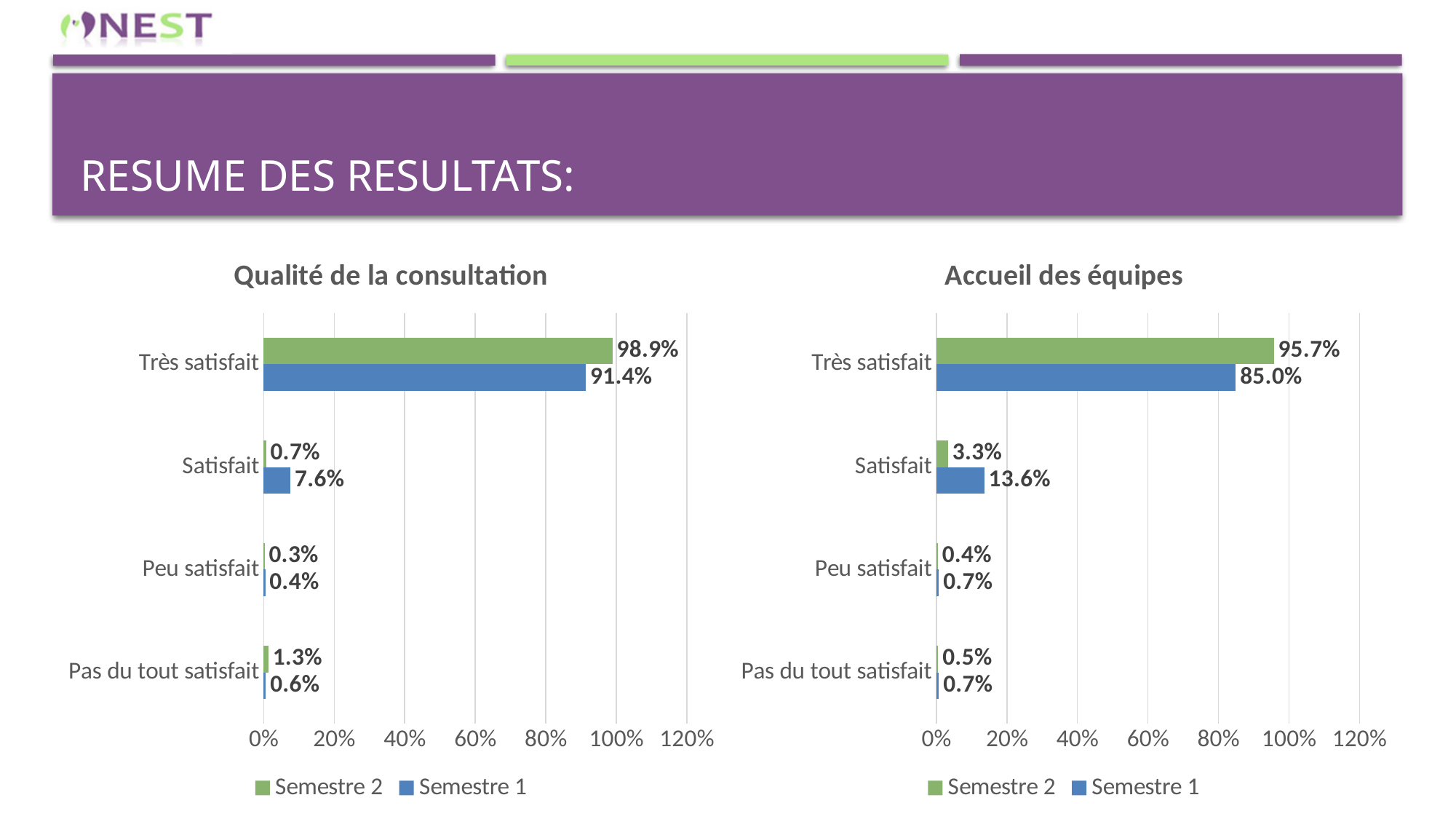
In the 'Accueil des équipes' chart, what is the difference between the Semestre 1 and Semestre 2 values for Satisfait? 10.3% In the 'Accueil des équipes' chart, what is the value for Satisfait in Semestre 2? 3.3% In the 'Accueil des équipes' chart, which is larger for Très satisfait: Semestre 1 or Semestre 2? Semestre 2 How many categories are shown in the 'Qualité de la consultation' chart? 4 What type of chart is the 'Qualité de la consultation' chart? Bar chart How many series does the legend of the 'Accueil des équipes' chart list? 2 In the 'Qualité de la consultation' chart, what is the difference between the Semestre 2 and Semestre 1 values for Très satisfait? 7.5% In the 'Qualité de la consultation' chart, what is the value for Très satisfait in Semestre 2? 98.9% In the 'Qualité de la consultation' chart, what is the value for Satisfait in Semestre 1? 7.6% In the 'Accueil des équipes' chart, which category has the highest value for Semestre 2? Très satisfait In the 'Accueil des équipes' chart, what is the value for Très satisfait in Semestre 1? 85.0% In the 'Qualité de la consultation' chart, which category has the lowest value for Semestre 2? Peu satisfait